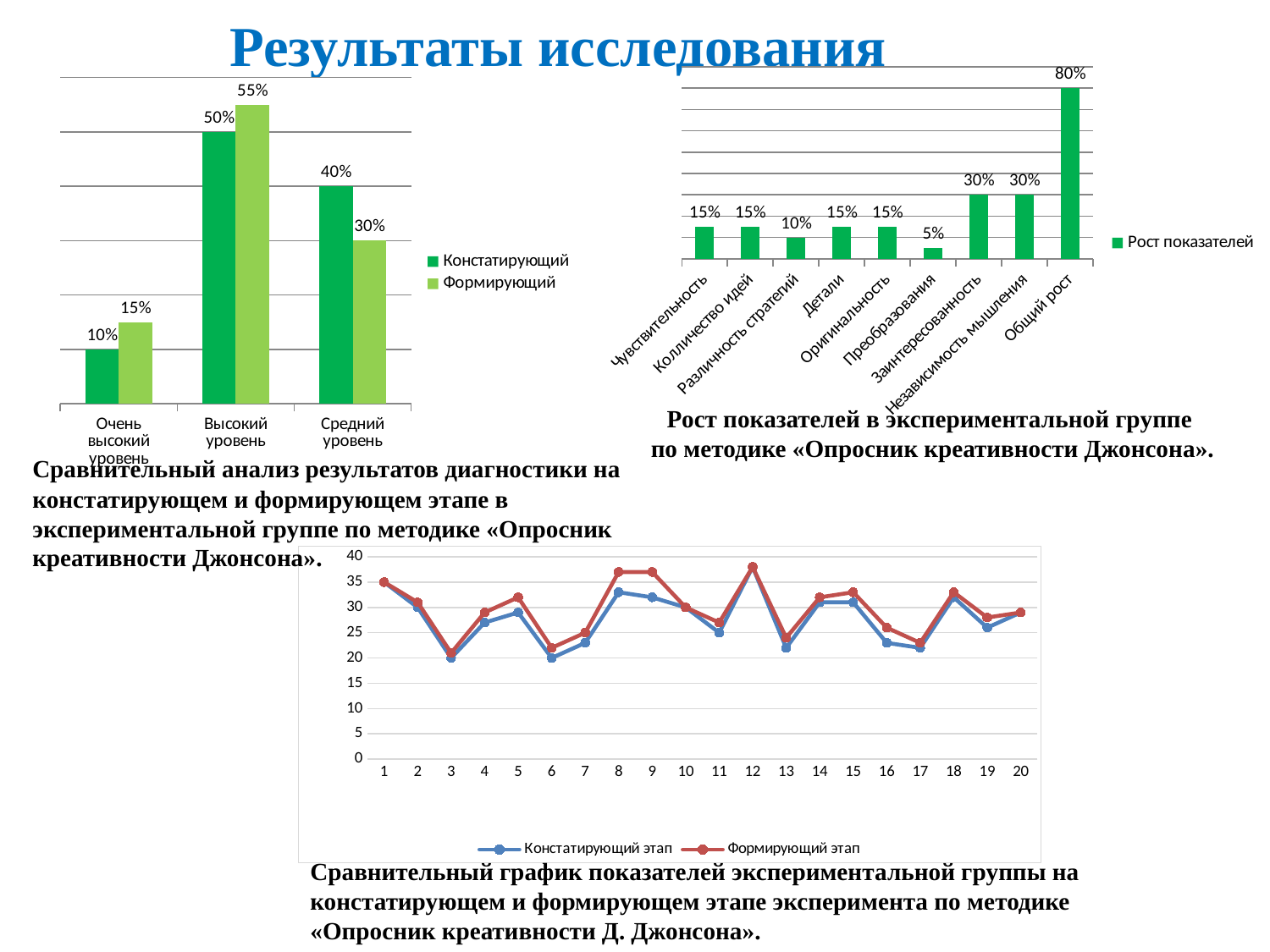
In the top-right chart titled Рост показателей, what is the difference between Общий рост and Независимость мышления? 50% In the top-left bar chart, what is the value for Высокий уровень in the Формирующий series? 55% In the top-right chart titled Рост показателей, which category has the lowest value? Преобразования How many categories are shown in the top-right chart titled Рост показателей? 9 How many series does the legend of the top-left bar chart list? 2 In the top-right chart titled Рост показателей, what is the value for Заинтересованность? 30% In the top-left bar chart, what is the value for Средний уровень in the Констатирующий series? 40% In the top-left bar chart, what is the difference between the Констатирующий and Формирующий values for Очень высокий уровень? 5% In the top-right chart titled Рост показателей, which category has the highest value? Общий рост In the top-left bar chart, which series has the larger value for Средний уровень, Констатирующий or Формирующий? Констатирующий In the bottom line chart, is the value for point 12 in the Формирующий этап series greater or less than 35? greater What kind of chart is the bottom chart comparing Констатирующий этап and Формирующий этап? line chart